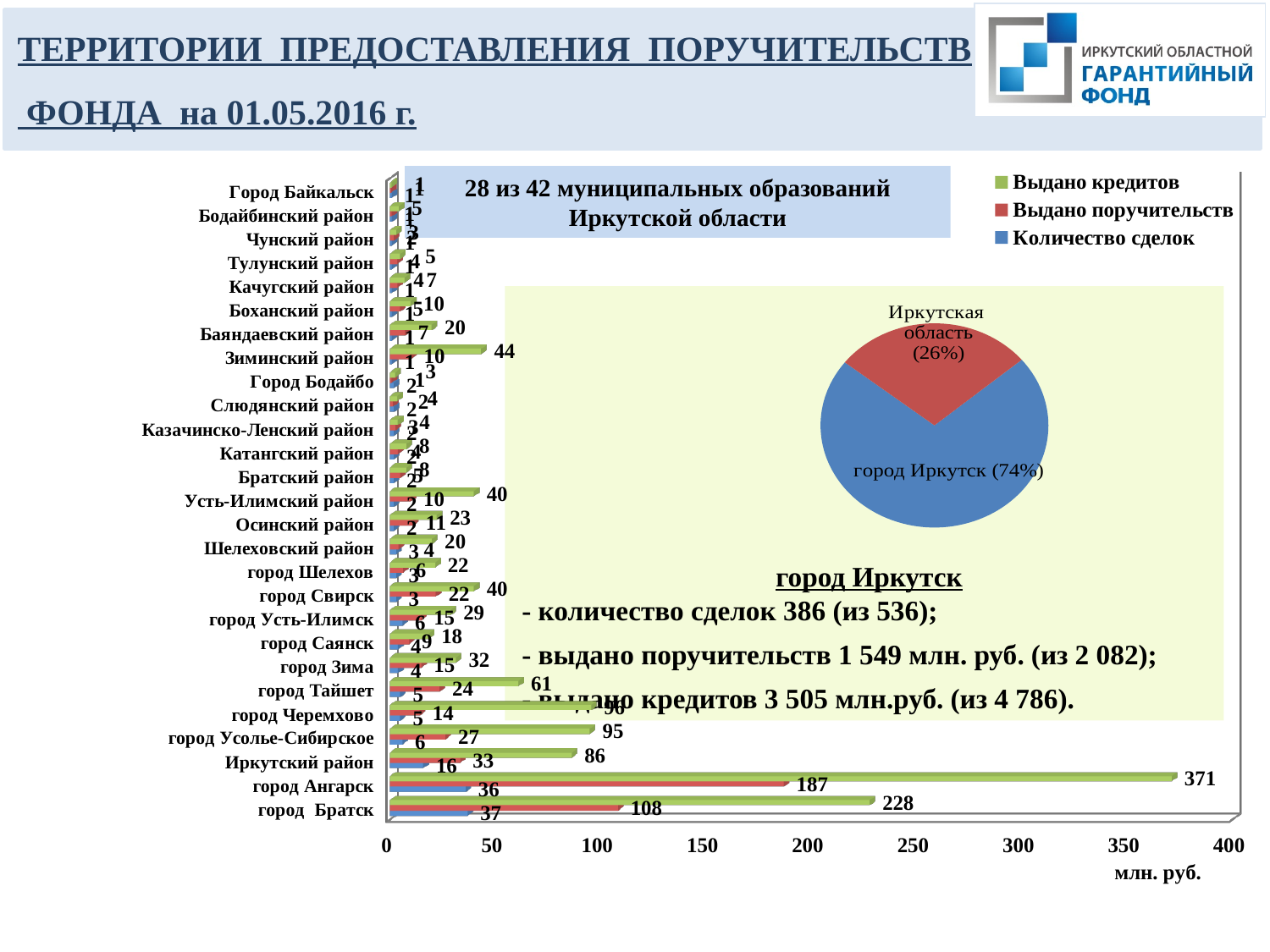
In the bar chart, is the value of Выдано поручительств for город Ангарск greater or less than 150? greater How many series does the legend of the bar chart list? 3 In the bar chart, which territory has the highest value of Выдано кредитов? город Ангарск What kind of chart is the large chart on the left of the slide? bar chart In the bar chart, which has the larger value of Выдано кредитов: город Усолье-Сибирское or Иркутский район? город Усолье-Сибирское In the bar chart, what is the value of Выдано поручительств for город Братск? 108 In the bar chart, what is the value of Количество сделок for Иркутский район? 16 What unit is shown under the horizontal axis of the bar chart? млн. руб. In the pie chart, what share does город Иркутск have? 74% In the bar chart, what is the difference between Выдано кредитов for город Ангарск and for город Братск? 143 In the pie chart, what share does Иркутская область have? 26% In the bar chart, what is the value of Выдано кредитов for город Ангарск? 371